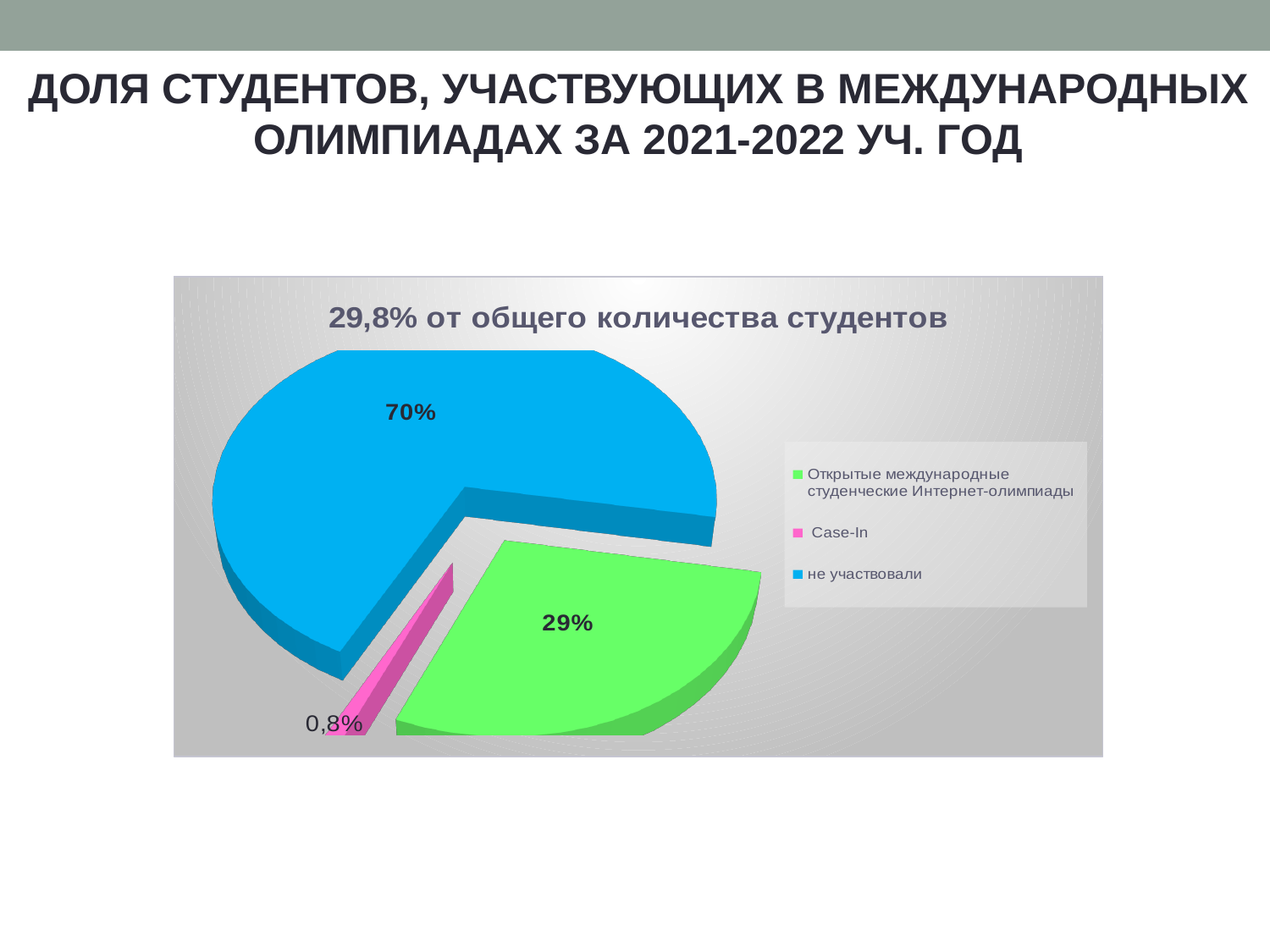
What share of the pie is labelled for "Case-In"? 0,8% How many entries does the legend list? 3 What colour is the slice for "Case-In"? pink What is the chart's title? 29,8% от общего количества студентов What share of the pie is labelled for "Открытые международные студенческие Интернет-олимпиады"? 29% What kind of chart is shown on the slide? pie chart Which slice is the largest? не участвовали What is the difference in percentage points between the "не участвовали" slice and the "Открытые международные студенческие Интернет-олимпиады" slice? 41 How many slices does the pie chart have? 3 What share of the pie is labelled for "не участвовали"? 70% Which is larger: the slice for "не участвовали" or the slice for "Открытые международные студенческие Интернет-олимпиады"? не участвовали Which slice is the smallest? Case-In